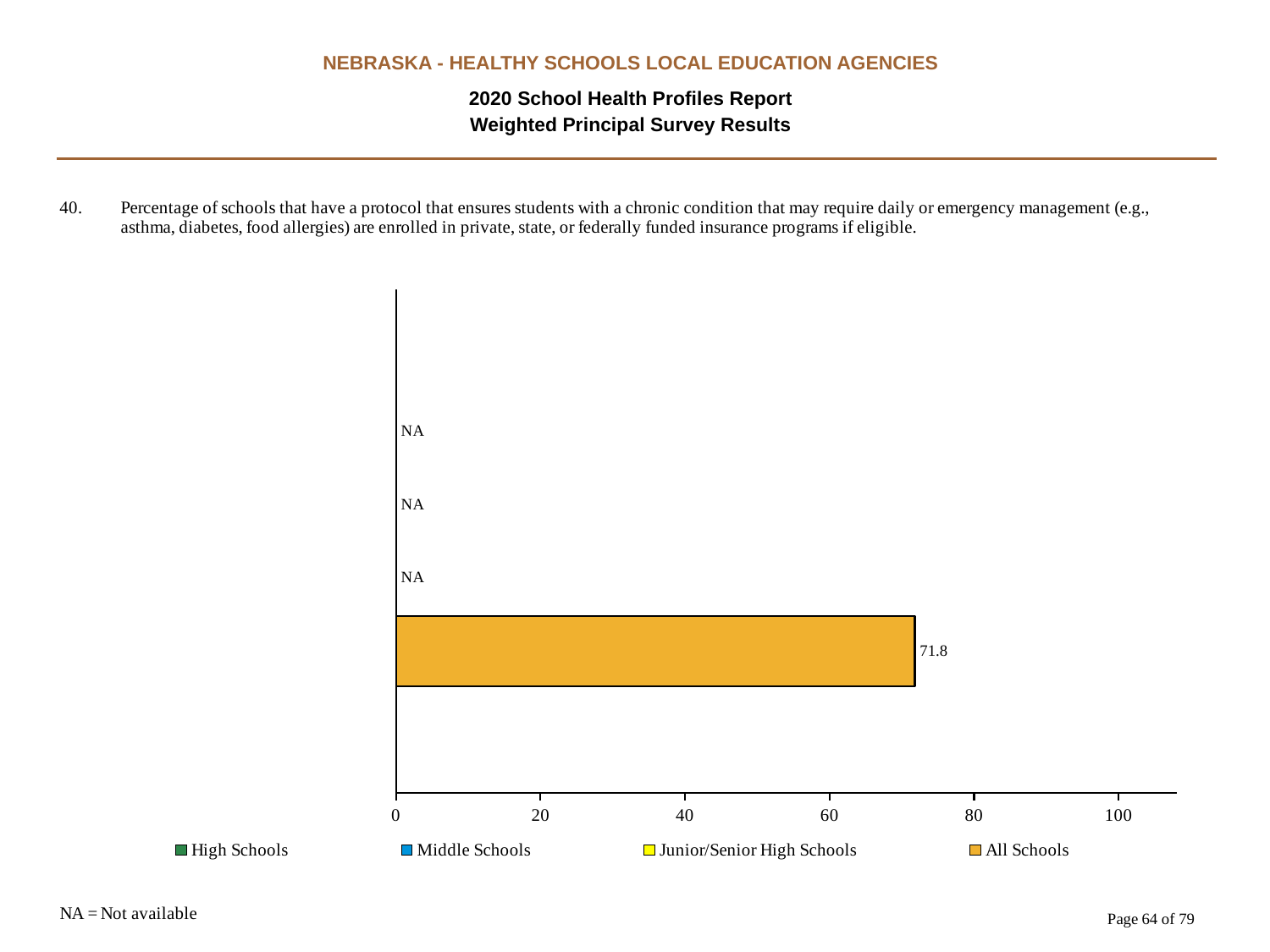
What value is shown for High Schools? NA Is the value for All Schools greater or less than 80? less Which series is the only one with a plotted bar? All Schools What is the highest value shown on the x axis? 100 How many series are marked NA on the chart? 3 What value is shown for Junior/Senior High Schools? NA What is the value for All Schools? 71.8 Is the value for All Schools greater or less than 60? greater What kind of chart is shown on the slide? Bar chart How many series does the legend list? 4 What value is shown for Middle Schools? NA